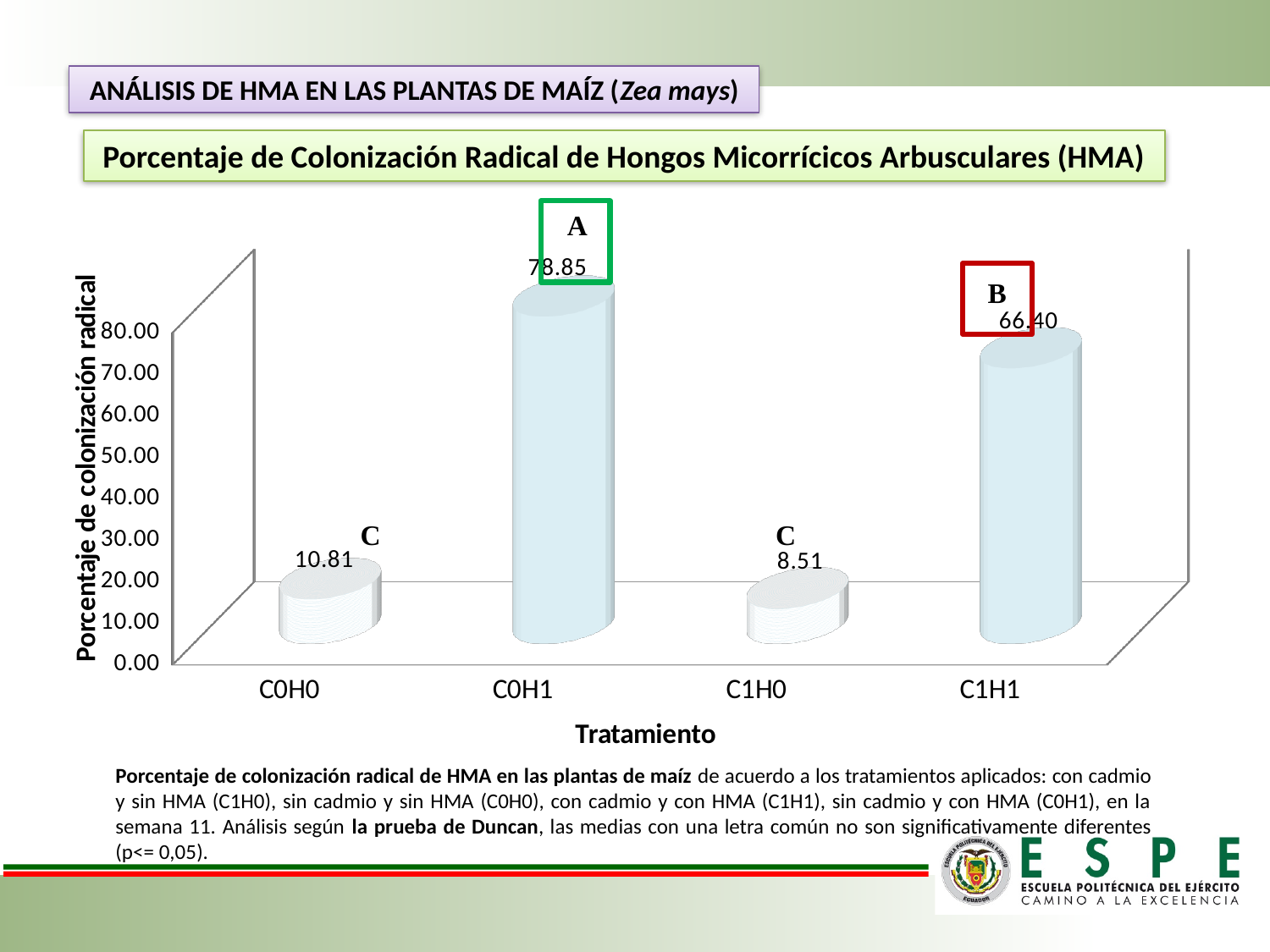
Which treatment has the lowest percentage of root colonization? C1H0 What kind of chart is shown on the slide? Bar chart Which is larger, the value for C0H0 or the value for C1H0? C0H0 What is the value for treatment C0H0? 10.81 What is the difference between the values for C0H1 and C1H1? 12.45 What is the difference between the values for C0H0 and C1H0? 2.30 What is the value for treatment C0H1? 78.85 How many treatments are shown on the x axis? 4 Which treatment has the highest percentage of root colonization? C0H1 What is the label of the x axis? Tratamiento What is the value for treatment C1H1? 66.40 What is the value for treatment C1H0? 8.51